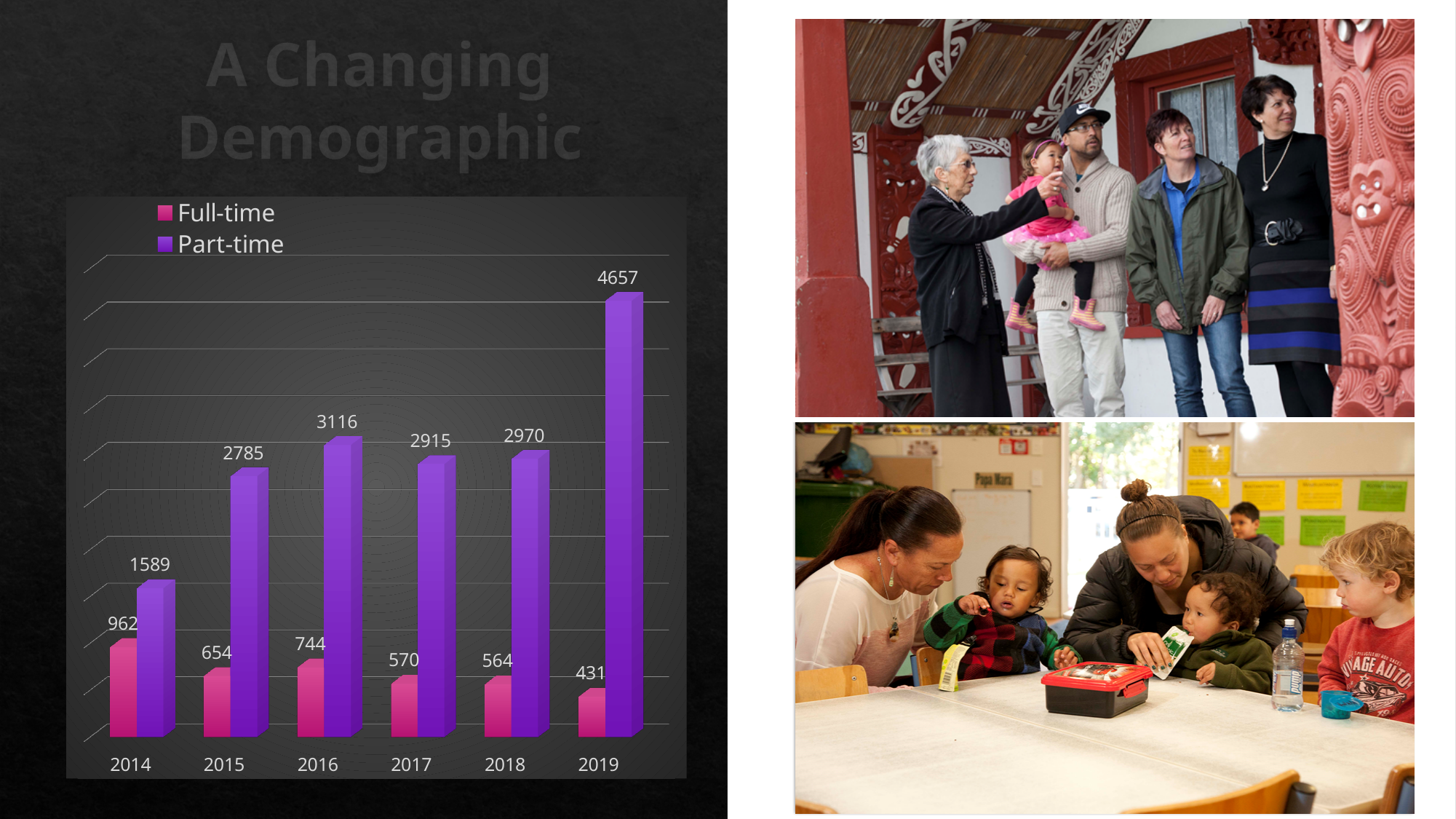
Does the Full-time series generally rise or fall from 2014 to 2019? Fall What is the Part-time value for 2016? 3116 What is the difference between the Part-time and Full-time values in 2015? 2131 How many years are shown on the x axis of the chart? 6 What is the Part-time value for 2019? 4657 What is the Full-time value for 2014? 962 How many series does the chart legend list? 2 What kind of chart is shown on the slide? Bar chart Which year has the highest Part-time value? 2019 Which is larger, the Full-time value for 2016 or the Full-time value for 2017? Full-time value for 2016 Which year has the lowest Full-time value? 2019 What is the Full-time value for 2018? 564